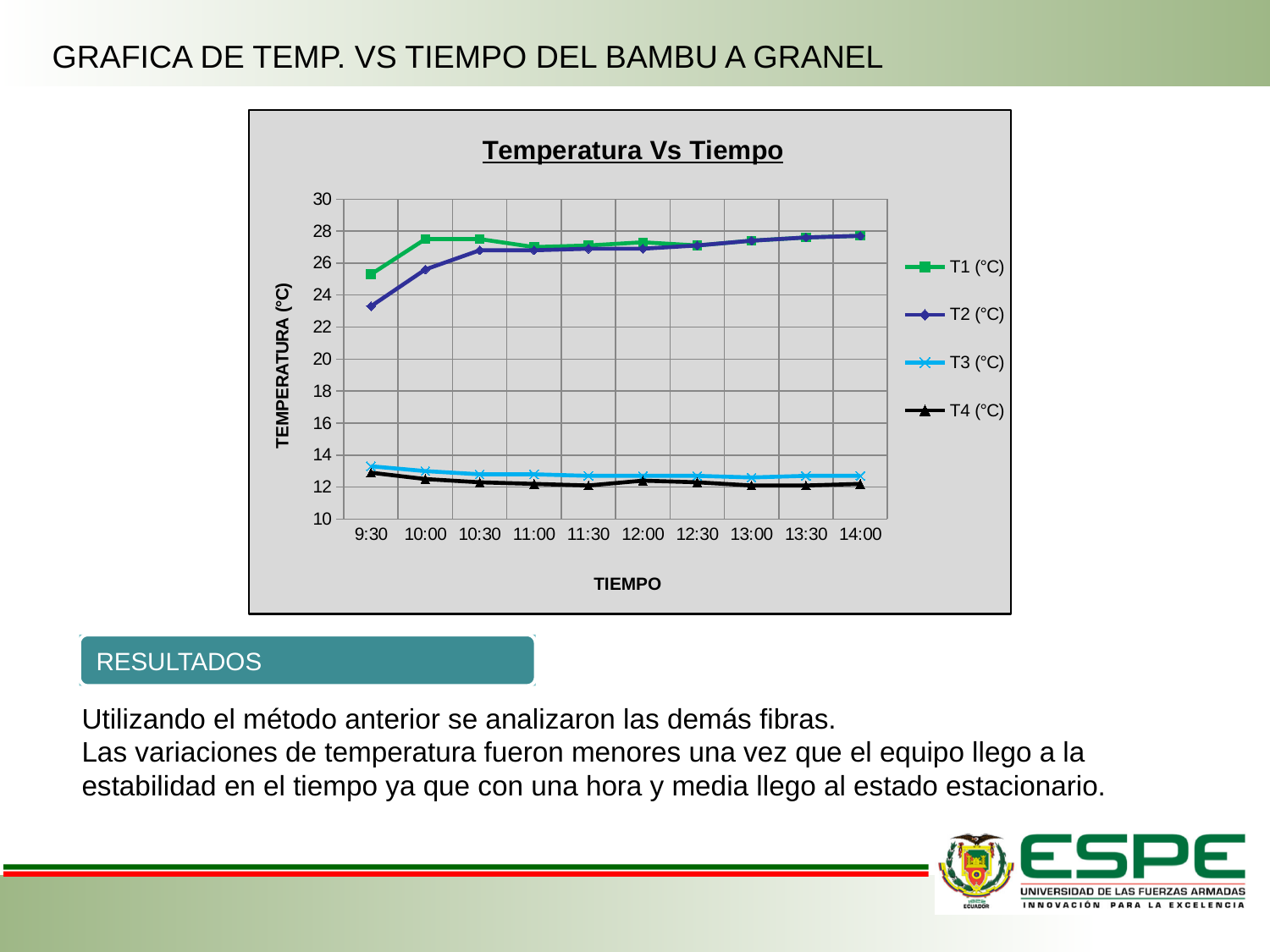
What kind of chart is shown on the slide? line chart How many series does the legend list? 4 Is the value for T4 (°C) at 9:30 greater or less than 14? less Is the value for T3 (°C) at 14:00 greater or less than 14? less How many time points are plotted along the x axis? 10 Is the value for T2 (°C) at 9:30 greater or less than 22? greater Which series has the highest value at 9:30? T1 (°C) What is the title of the chart? Temperatura Vs Tiempo Which series has the lowest value at 12:00? T4 (°C) What is the label of the y axis? TEMPERATURA (°C) Does the T2 (°C) series rise or fall from 9:30 to 14:00? rise